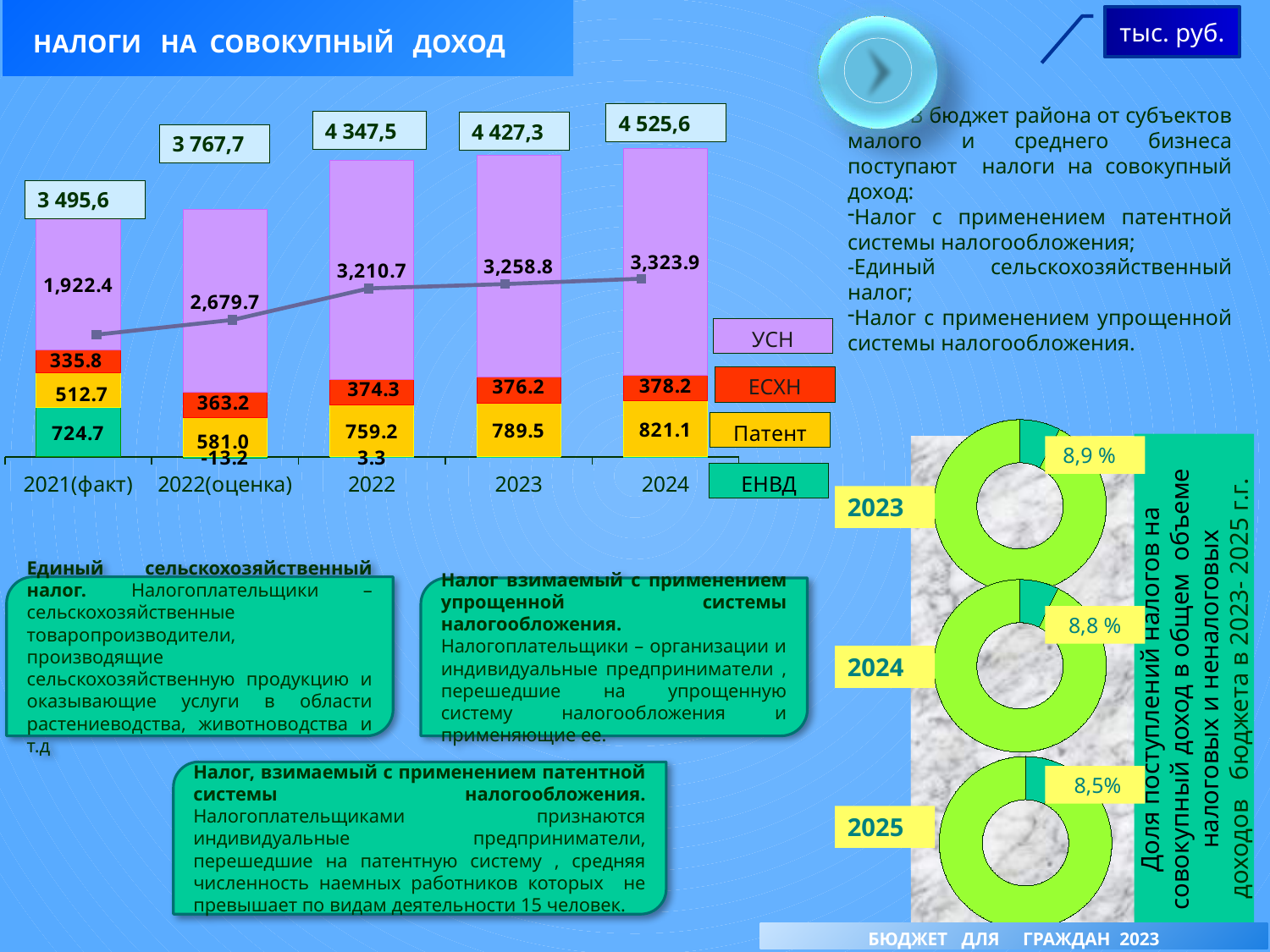
In the 'НАЛОГИ НА СОВОКУПНЫЙ ДОХОД' chart, what is the total shown above the 2024 bar? 4 525,6 In the 'НАЛОГИ НА СОВОКУПНЫЙ ДОХОД' chart, which year has the highest total? 2024 In the 'НАЛОГИ НА СОВОКУПНЫЙ ДОХОД' chart, what is the ЕНВД value for 2021(факт)? 724.7 In the 'НАЛОГИ НА СОВОКУПНЫЙ ДОХОД' chart, what is the ЕСХН value for 2023? 376.2 What kind of chart is the main chart titled 'НАЛОГИ НА СОВОКУПНЫЙ ДОХОД'? Stacked bar chart In the donut charts on the right, what share is shown for 2025? 8,5% In the 'НАЛОГИ НА СОВОКУПНЫЙ ДОХОД' chart, what is the difference between the Патент value for 2023 and for 2022? 30.3 How many series does the legend of the 'НАЛОГИ НА СОВОКУПНЫЙ ДОХОД' chart list? 4 In the 'НАЛОГИ НА СОВОКУПНЫЙ ДОХОД' chart, do the bar totals rise or fall from 2021(факт) to 2024? Rise How many categories are shown on the x axis of the 'НАЛОГИ НА СОВОКУПНЫЙ ДОХОД' chart? 5 In the 'НАЛОГИ НА СОВОКУПНЫЙ ДОХОД' chart, which year has the lowest total? 2021(факт) In the 'НАЛОГИ НА СОВОКУПНЫЙ ДОХОД' chart, what is the Патент value for 2024? 821.1